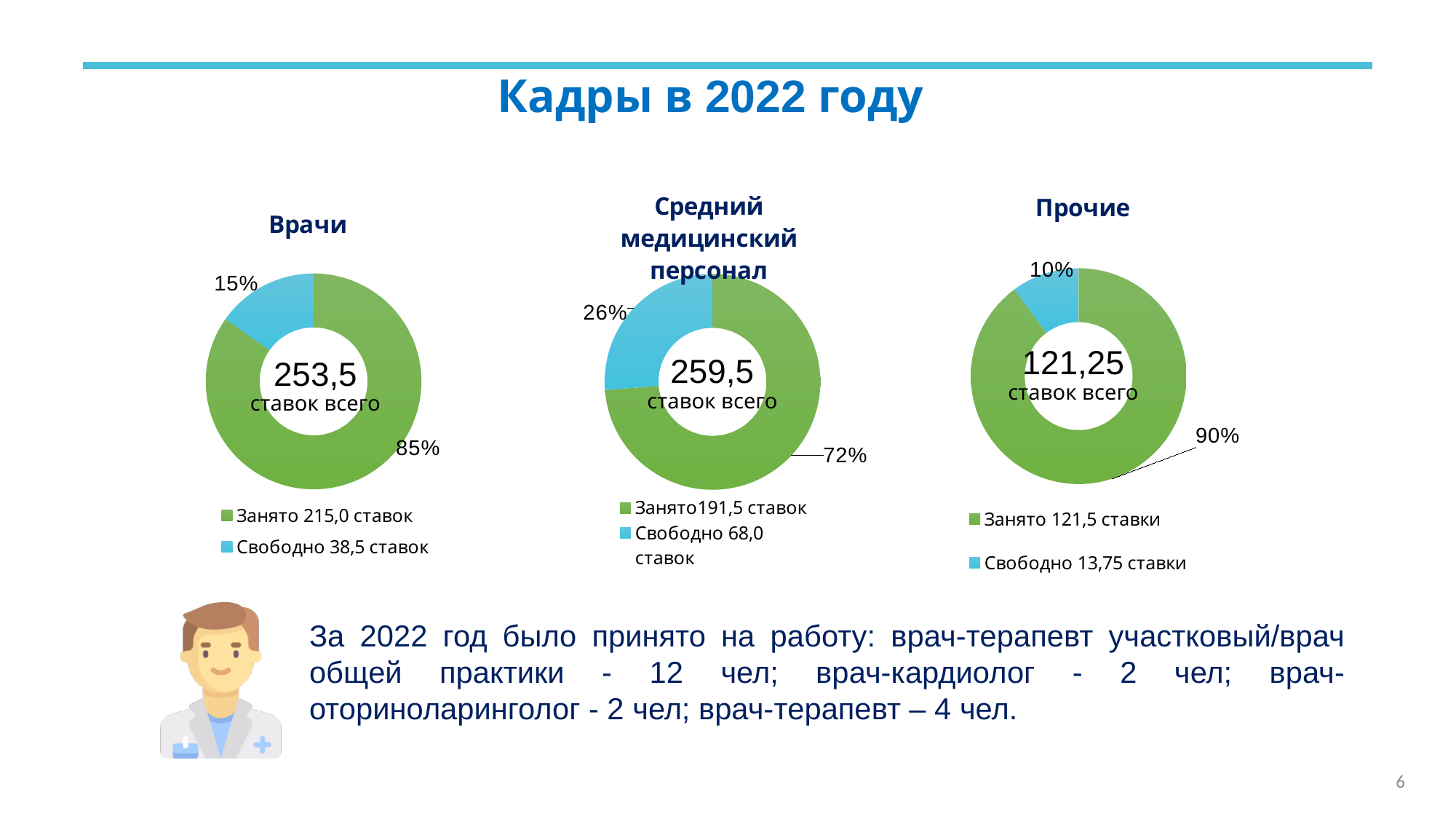
In the "Средний медицинский персонал" chart, what share is labelled as occupied (Занято)? 72% What total number of positions is shown in the centre of the "Средний медицинский персонал" chart? 259,5 In the "Прочие" chart, which slice is larger: Занято or Свободно? Занято In the "Врачи" chart, what share of the total is labelled as occupied (Занято)? 85% In the "Средний медицинский персонал" chart, what share is labelled as free (Свободно)? 26% According to the legend of the "Врачи" chart, how many positions are free (Свободно)? 38,5 ставок How many slices does the "Средний медицинский персонал" chart have? 2 What total number of positions is shown in the centre of the "Врачи" chart? 253,5 What kind of chart is used for "Врачи"? Doughnut (pie) chart What total number of positions is shown in the centre of the "Прочие" chart? 121,25